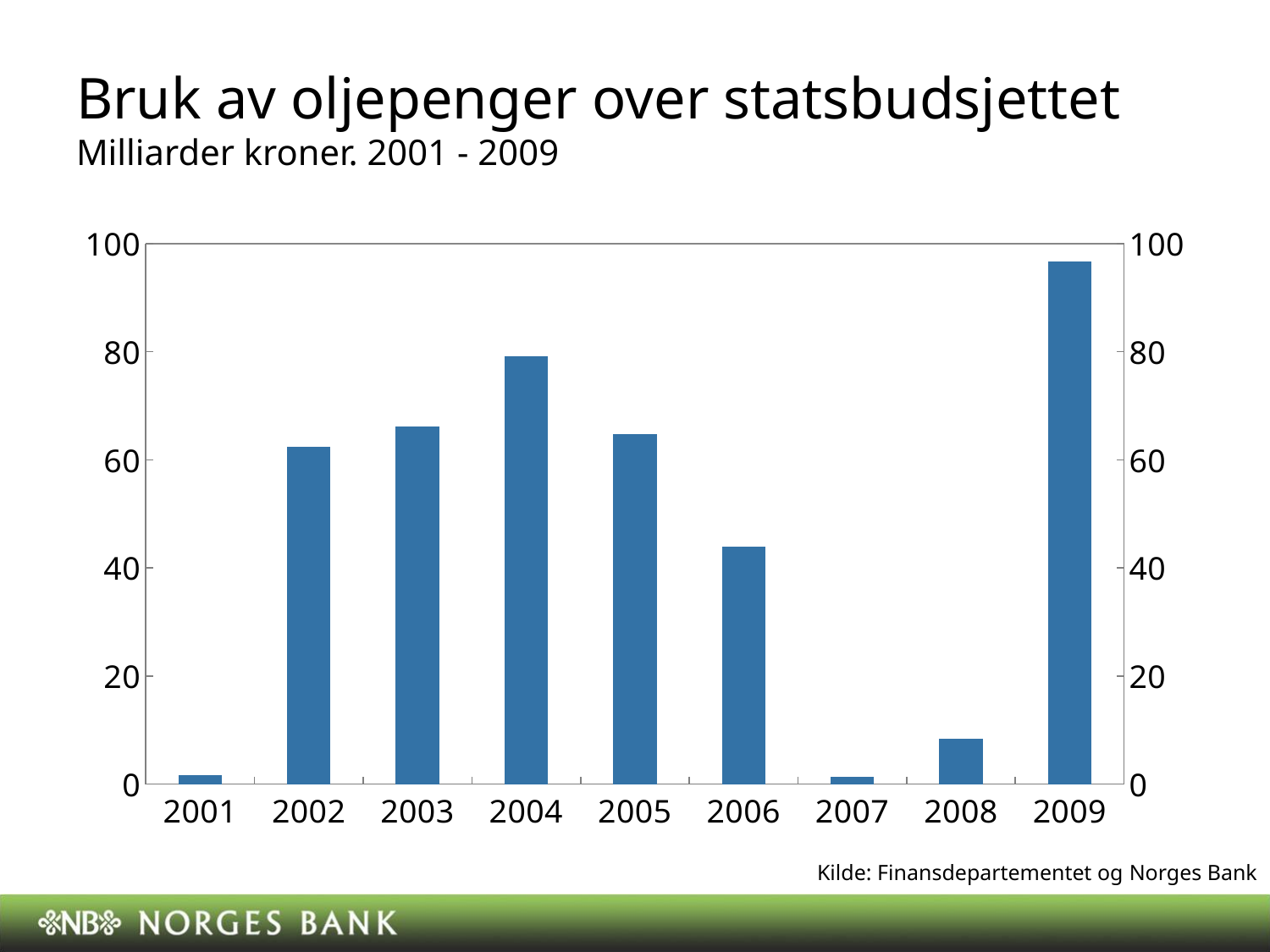
Which year has the highest value in the chart? 2009 How many years are shown on the x axis of the chart? 9 What is the title of the chart on the slide? Bruk av oljepenger over statsbudsjettet Is the value for 2004 greater or less than 60? greater Do the values rise or fall from 2004 to 2007? fall Is the value for 2008 greater or less than 20? less Which is larger, the value for 2004 or the value for 2003? 2004 Which is larger, the value for 2005 or the value for 2006? 2005 Is the value for 2006 greater or less than 60? less What kind of chart is shown on the slide? bar chart